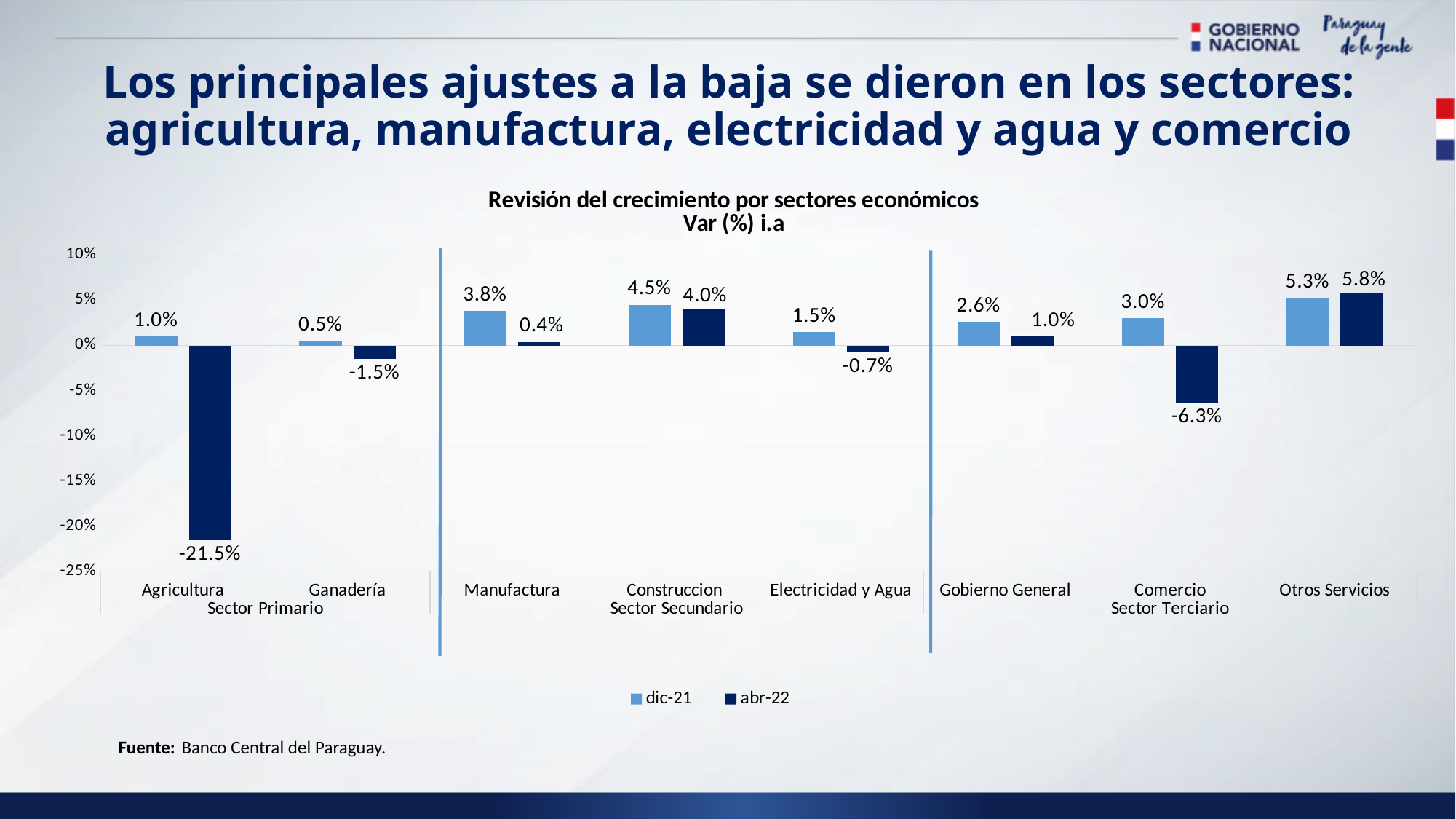
What is the abr-22 value for Agricultura? -21.5% How many series does the legend list? 2 For Otros Servicios, which is larger: the dic-21 value or the abr-22 value? abr-22 Which category has the highest dic-21 value? Otros Servicios How many categories are shown on the x axis? 8 Which category has the lowest abr-22 value? Agricultura What is the difference between the dic-21 and abr-22 values for Manufactura? 3.4 percentage points What is the dic-21 value for Electricidad y Agua? 1.5% What type of chart is shown? Bar chart What is the abr-22 value for Comercio? -6.3% What is the dic-21 value for Construccion? 4.5% Which category has the highest abr-22 value? Otros Servicios